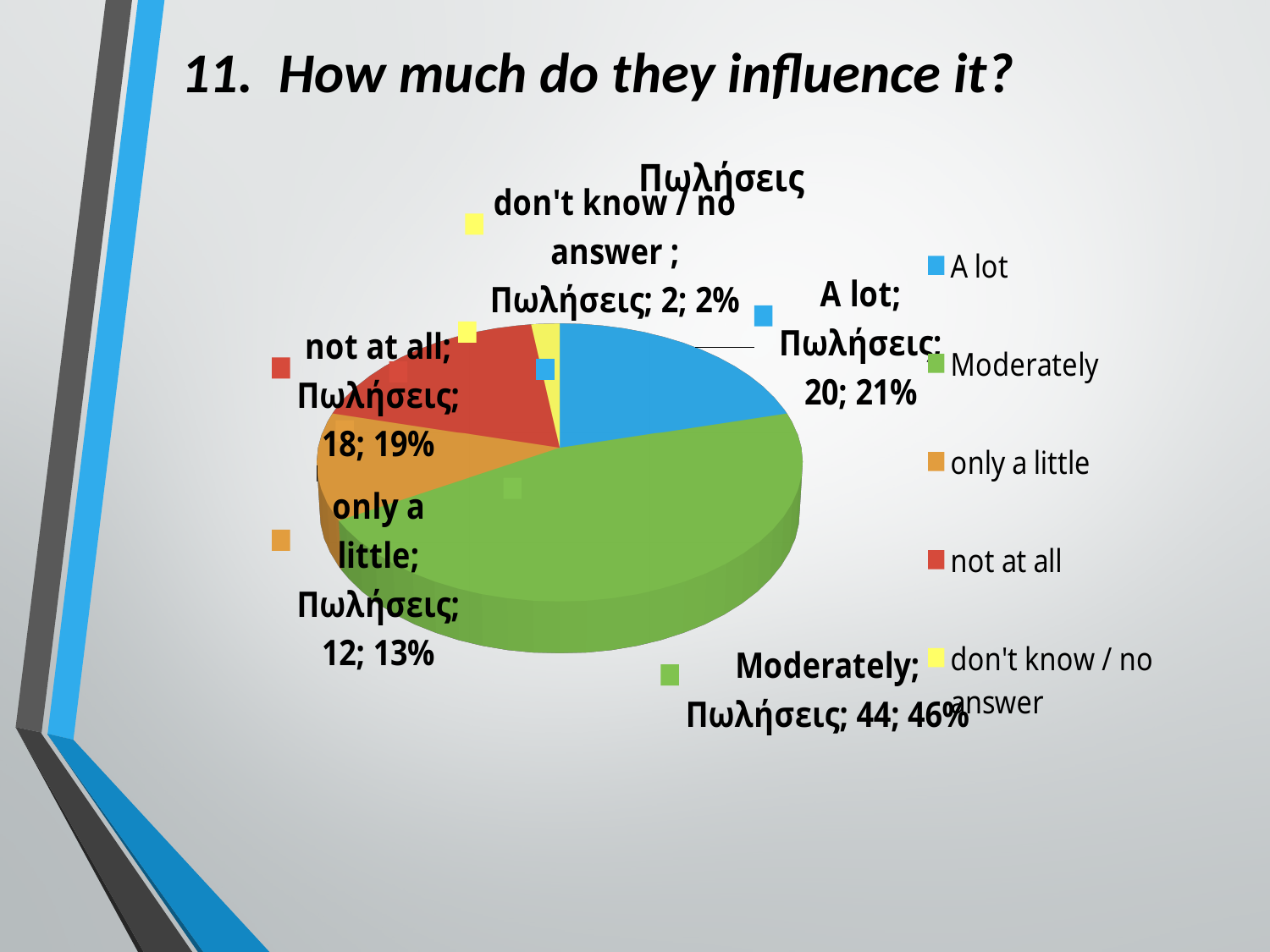
How many categories does the pie chart have? 5 What is the value for "don't know / no answer"? 2 What percentage share does "only a little" have? 13% What is the title of the chart? Πωλήσεις What is the value for "Moderately"? 44 What is the difference between the values for "Moderately" and "A lot"? 24 Which is larger, the value for "not at all" or the value for "only a little"? not at all What kind of chart is shown on the slide? pie chart What is the value for "not at all"? 18 What percentage share does "A lot" have? 21% Which category has the smallest slice? don't know / no answer Which category has the largest slice? Moderately